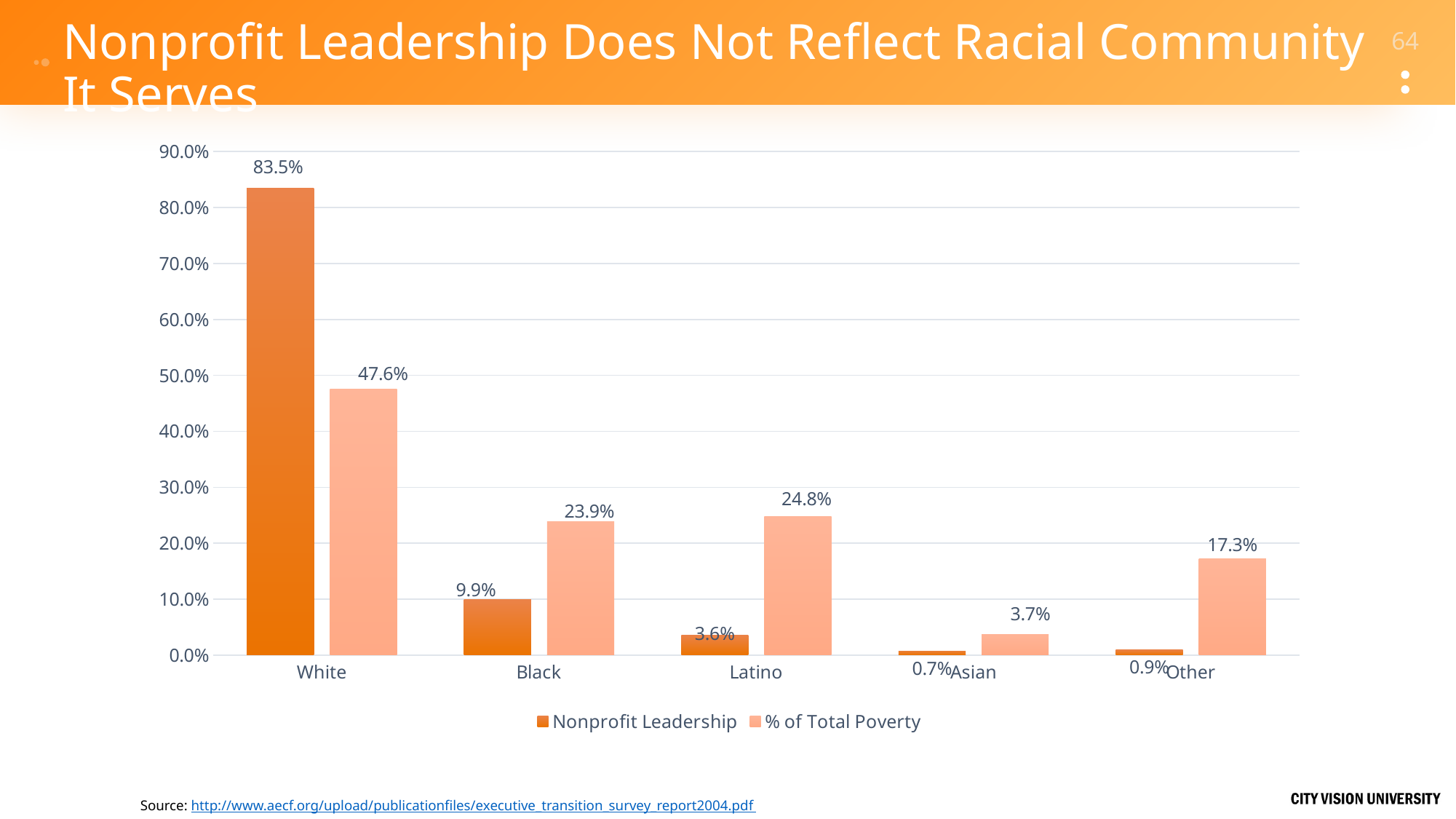
Which category has the highest % of Total Poverty value? White What are the two series named in the legend? Nonprofit Leadership and % of Total Poverty What kind of chart is shown on the slide? Bar chart What is the difference between the Nonprofit Leadership and % of Total Poverty values for Black? 14.0% What is the % of Total Poverty value for Other? 17.3% Which category has the lowest Nonprofit Leadership value? Asian Which is larger for Latino: Nonprofit Leadership or % of Total Poverty? % of Total Poverty How many series does the legend list? 2 What is the Nonprofit Leadership value for Asian? 0.7% What is the % of Total Poverty value for Latino? 24.8% How many categories are shown on the x axis? 5 What is the Nonprofit Leadership value for White? 83.5%